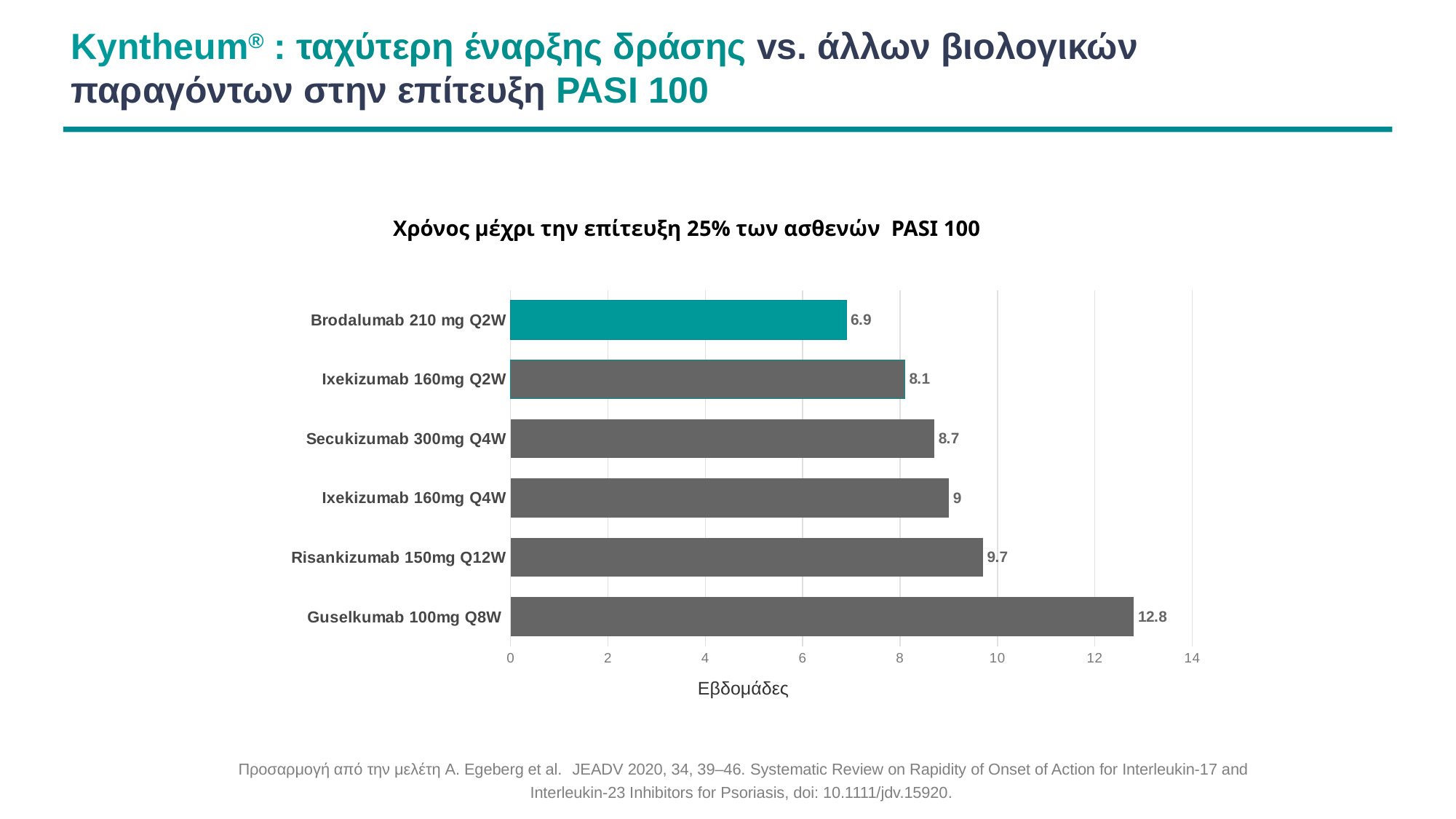
What is the value for Guselkumab 100mg Q8W? 12.8 Which category has the highest value? Guselkumab 100mg Q8W What is the label of the x axis? Εβδομάδες What is the value for Risankizumab 150mg Q12W? 9.7 How many categories are shown in the chart? 6 What is the difference between the values for Ixekizumab 160mg Q4W and Ixekizumab 160mg Q2W? 0.9 Which is larger, the value for Secukizumab 300mg Q4W or the value for Ixekizumab 160mg Q2W? Secukizumab 300mg Q4W What is the value for Brodalumab 210 mg Q2W? 6.9 What is the difference between the values for Guselkumab 100mg Q8W and Brodalumab 210 mg Q2W? 5.9 Is the value for Risankizumab 150mg Q12W greater or less than 8? greater Which category has the lowest value? Brodalumab 210 mg Q2W What kind of chart is shown on the slide? bar chart